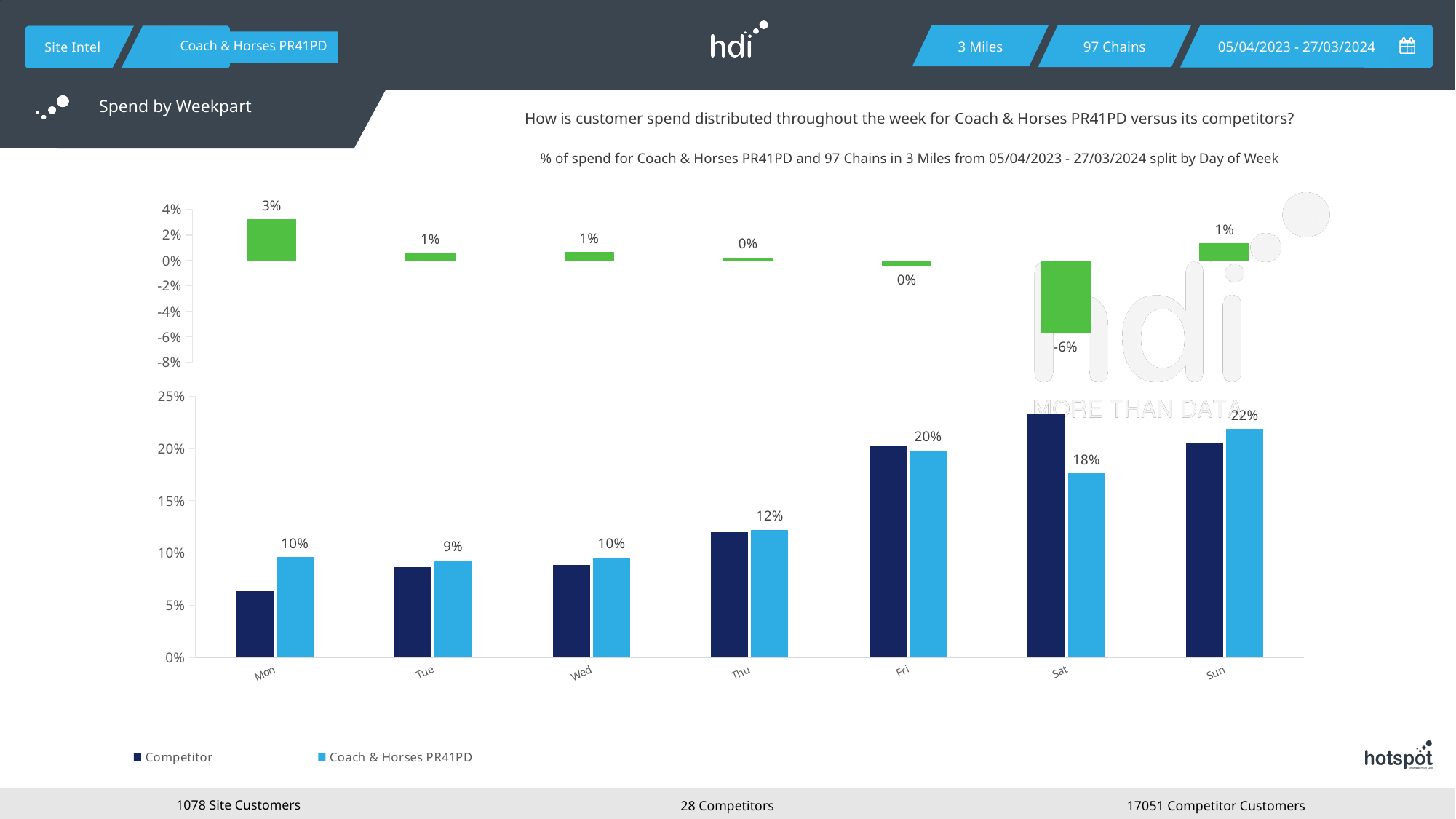
In the bottom bar chart, what is the value for Coach & Horses PR41PD on Thu? 12% In the bottom bar chart, is the Competitor value for Sat greater or less than 20%? greater In the bottom bar chart, what is the value for Coach & Horses PR41PD on Sun? 22% In the bottom bar chart, what is the difference between the Coach & Horses PR41PD values for Sun and Sat? 4% In the top chart, what is the value shown for Sat? -6% In the bottom bar chart, is the Competitor value for Mon greater or less than 10%? less In the bottom bar chart, on Sat, which is larger: the Competitor bar or the Coach & Horses PR41PD bar? Competitor In the bottom bar chart, which day has the lowest value for Coach & Horses PR41PD? Tue How many series does the legend of the bottom bar chart list? 2 In the top chart, which day has the highest value? Mon In the bottom bar chart, which day has the highest value for Coach & Horses PR41PD? Sun How many days are shown on the x axis of the bottom bar chart? 7